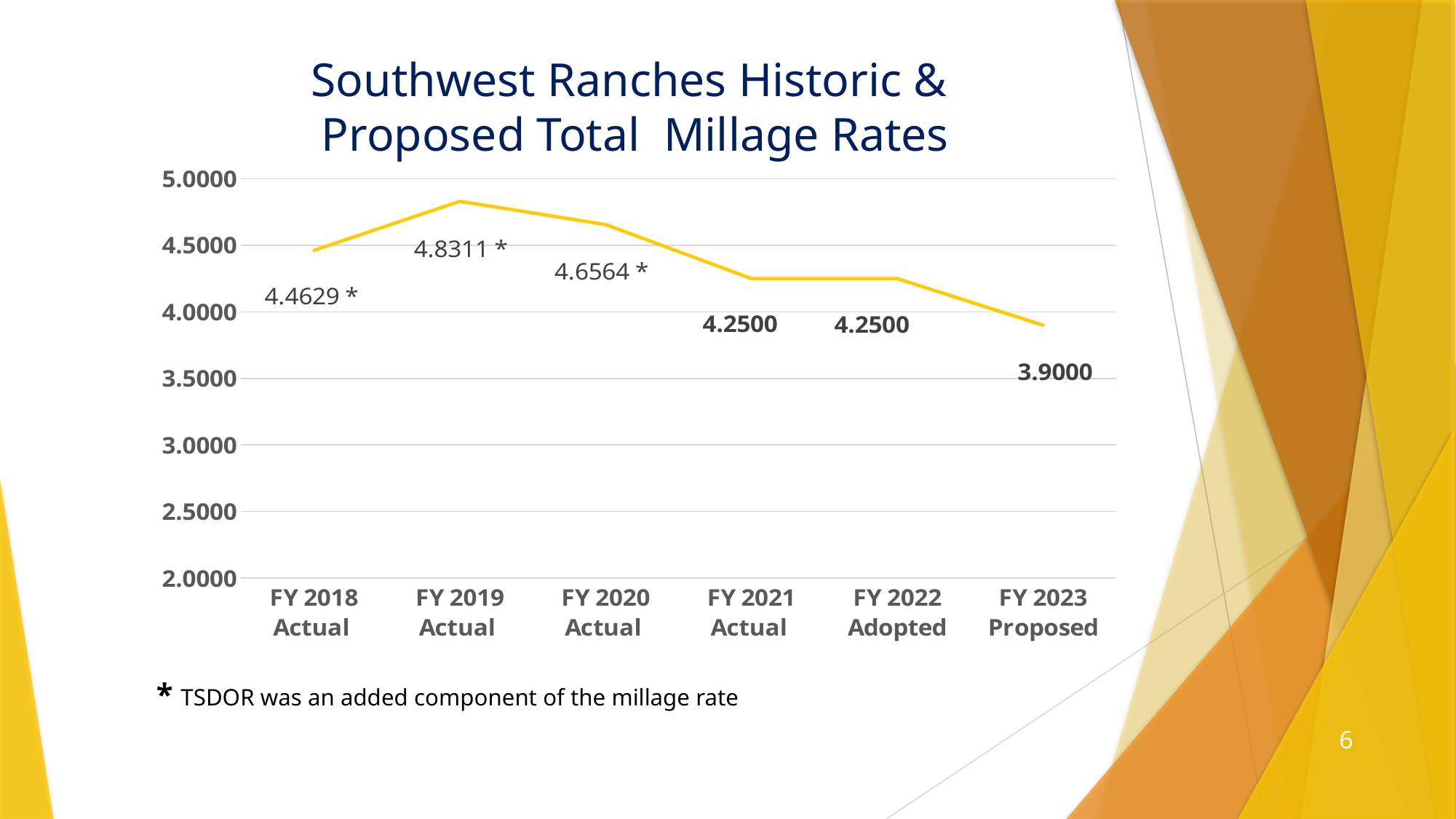
Which fiscal year has the lowest total millage rate? FY 2023 Proposed Do the millage rates rise or fall from FY 2019 Actual to FY 2023 Proposed? fall What is the total millage rate for FY 2020 Actual? 4.6564 What is the difference between the FY 2018 Actual and FY 2021 Actual millage rates? 0.2129 What is the difference between the FY 2019 Actual and FY 2023 Proposed millage rates? 0.9311 What kind of chart is shown on the slide? line chart Is the millage rate for FY 2023 Proposed greater or less than 4.0000? less Which is larger, the millage rate for FY 2018 Actual or FY 2020 Actual? FY 2020 Actual What is the proposed total millage rate for FY 2023? 3.9000 How many fiscal years are plotted on the chart? 6 What is the total millage rate for FY 2019 Actual? 4.8311 Which fiscal year has the highest total millage rate? FY 2019 Actual